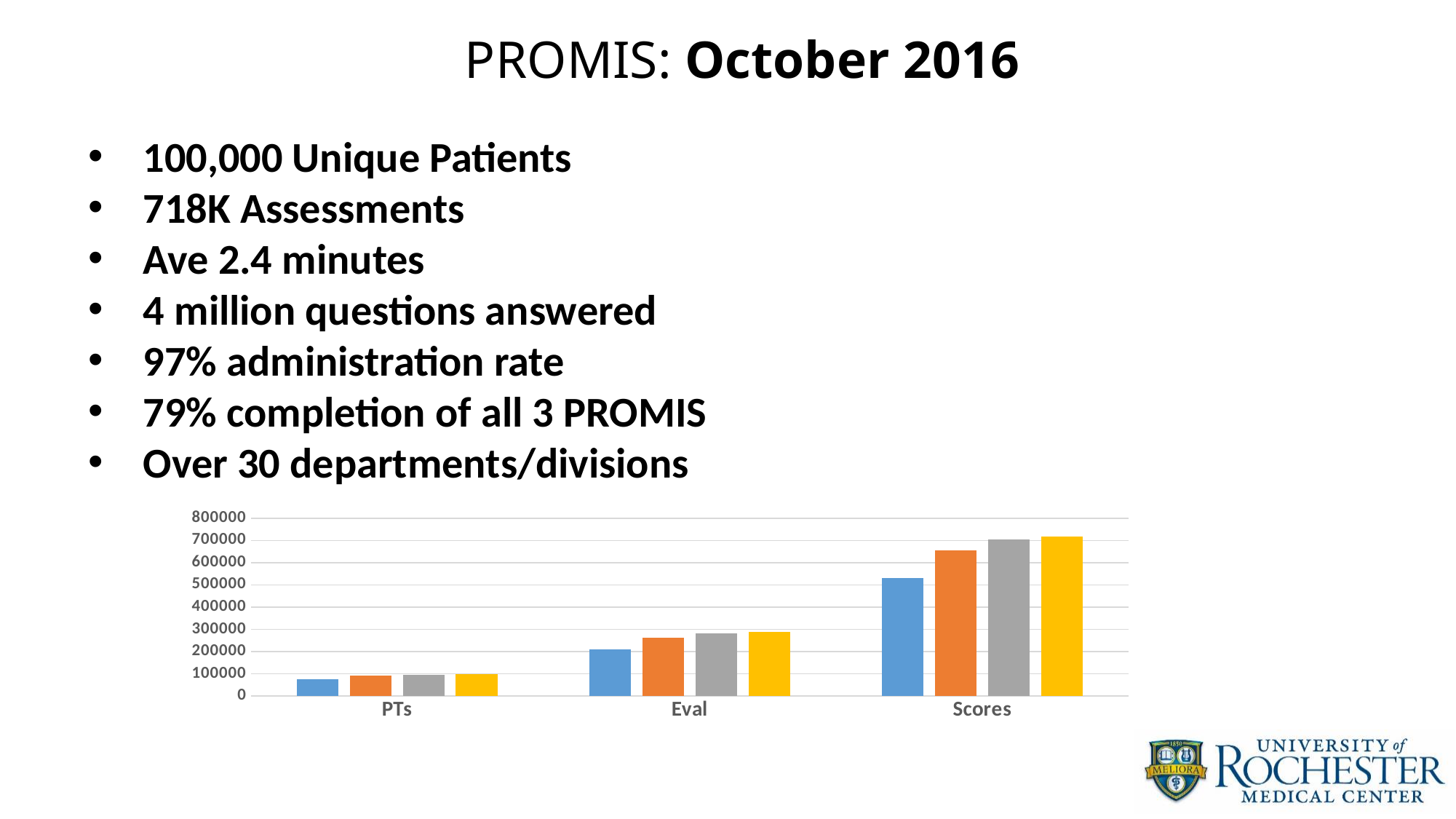
Is the value of the orange bar for Eval greater or less than 300000? less What is the highest value labelled on the chart's vertical axis? 800000 Is the value of the gray bar for Scores greater or less than 600000? greater How many bars are plotted for each category in the chart? 4 Do the bar heights rise or fall moving from PTs to Scores along the x axis? rise Is the value of the blue bar for Scores greater or less than 500000? greater Which category has the tallest bars in the chart? Scores Which category has the shortest bars in the chart? PTs How many categories are shown on the x axis of the chart? 3 What kind of chart is shown at the bottom of the slide? bar chart Are the bars for Scores taller or shorter than the bars for Eval? taller